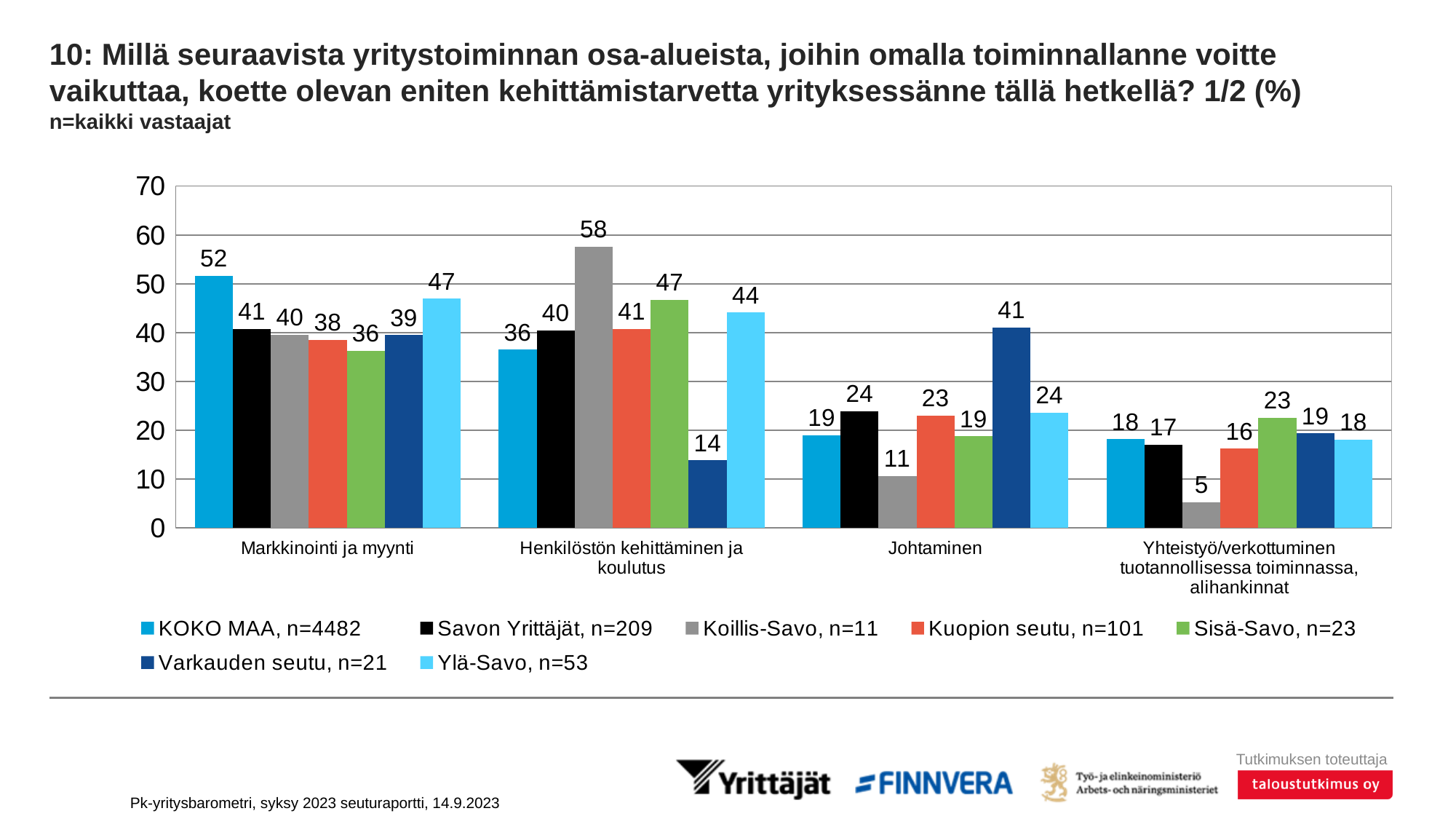
How many series does the legend list? 7 In the Markkinointi ja myynti category, which is larger: the value for KOKO MAA or the value for Ylä-Savo? KOKO MAA What is the value for Varkauden seutu in the Johtaminen category? 41 Which series has the lowest value in the Johtaminen category? Koillis-Savo Which series has the highest value in the Henkilöstön kehittäminen ja koulutus category? Koillis-Savo What is the difference between the Koillis-Savo and Varkauden seutu values in the Henkilöstön kehittäminen ja koulutus category? 44 What is the value for Koillis-Savo in the Yhteistyö/verkottuminen tuotannollisessa toiminnassa, alihankinnat category? 5 What kind of chart is shown on the slide? Bar chart What is the value for Koillis-Savo in the Henkilöstön kehittäminen ja koulutus category? 58 What is the value for KOKO MAA in the Markkinointi ja myynti category? 52 How many categories are shown on the x axis? 4 Which series in the legend has n=101? Kuopion seutu